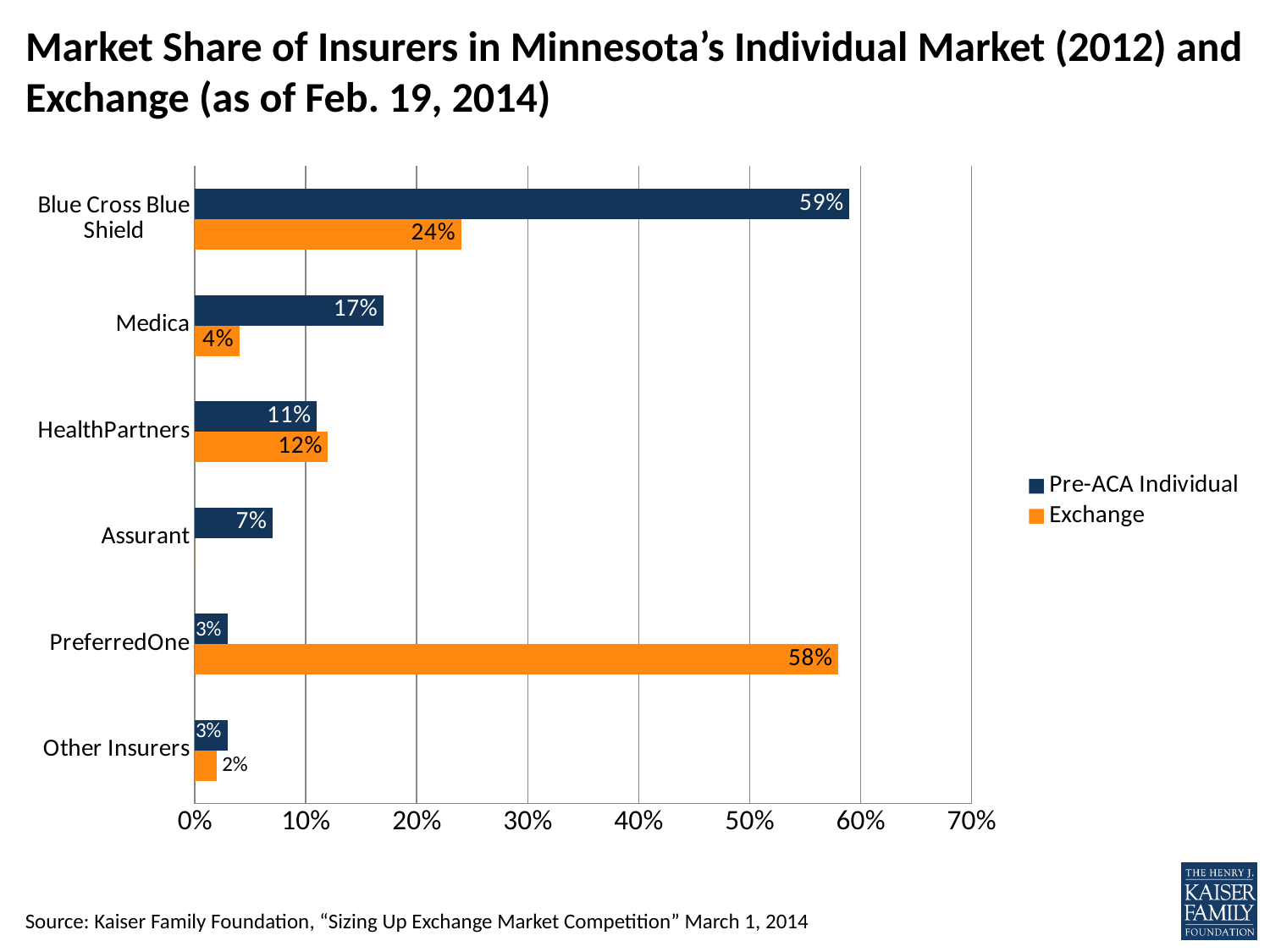
Which insurer has the highest Exchange market share? PreferredOne Which colour represents the Exchange series in the legend? Orange Which insurer has the highest Pre-ACA Individual market share? Blue Cross Blue Shield What is the Exchange market share for Medica? 4% What is the difference between Blue Cross Blue Shield's Pre-ACA Individual share and its Exchange share? 35% Which is larger for HealthPartners: the Pre-ACA Individual share or the Exchange share? Exchange What kind of chart is shown on the slide? Bar chart What is the Pre-ACA Individual market share for Blue Cross Blue Shield? 59% What is the Exchange market share for PreferredOne? 58% How many insurer categories are shown on the chart? 6 Is the Exchange market share for PreferredOne greater or less than 50%? greater How many series does the legend list? 2